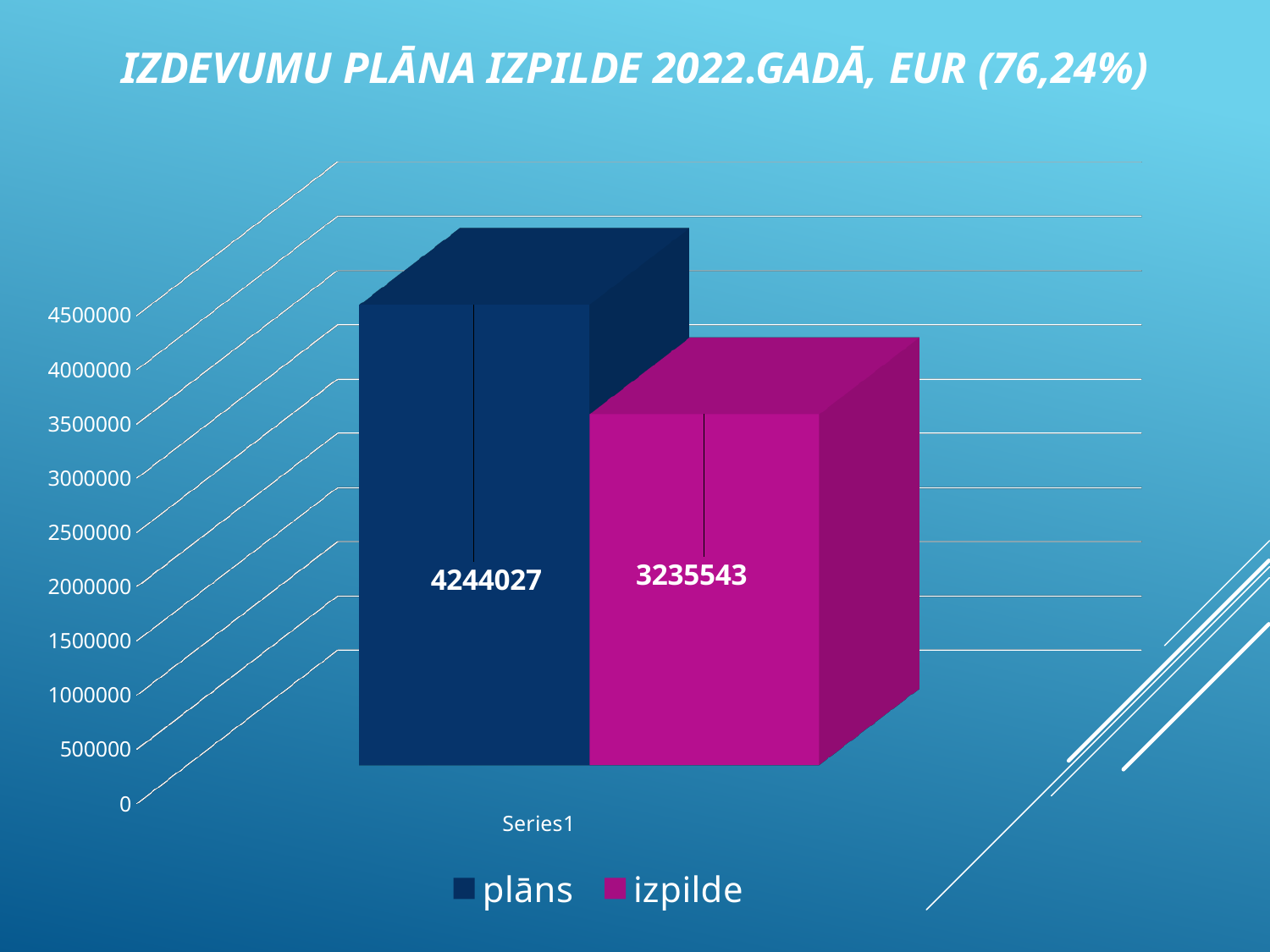
What colour is the bar for izpilde? magenta Is the value for plāns greater or less than 4500000? less What kind of chart is shown on the slide? bar chart What is the value for izpilde? 3235543 Which series has the lowest value? izpilde Which series has the higher value, plāns or izpilde? plāns What is the category label shown on the x axis? Series1 What is the value for plāns? 4244027 What is the difference between the plāns value and the izpilde value? 1008484 Is the value for izpilde greater or less than 3000000? greater What is the title of the chart? IZDEVUMU PLĀNA IZPILDE 2022.GADĀ, EUR (76,24%) How many series does the legend list? 2